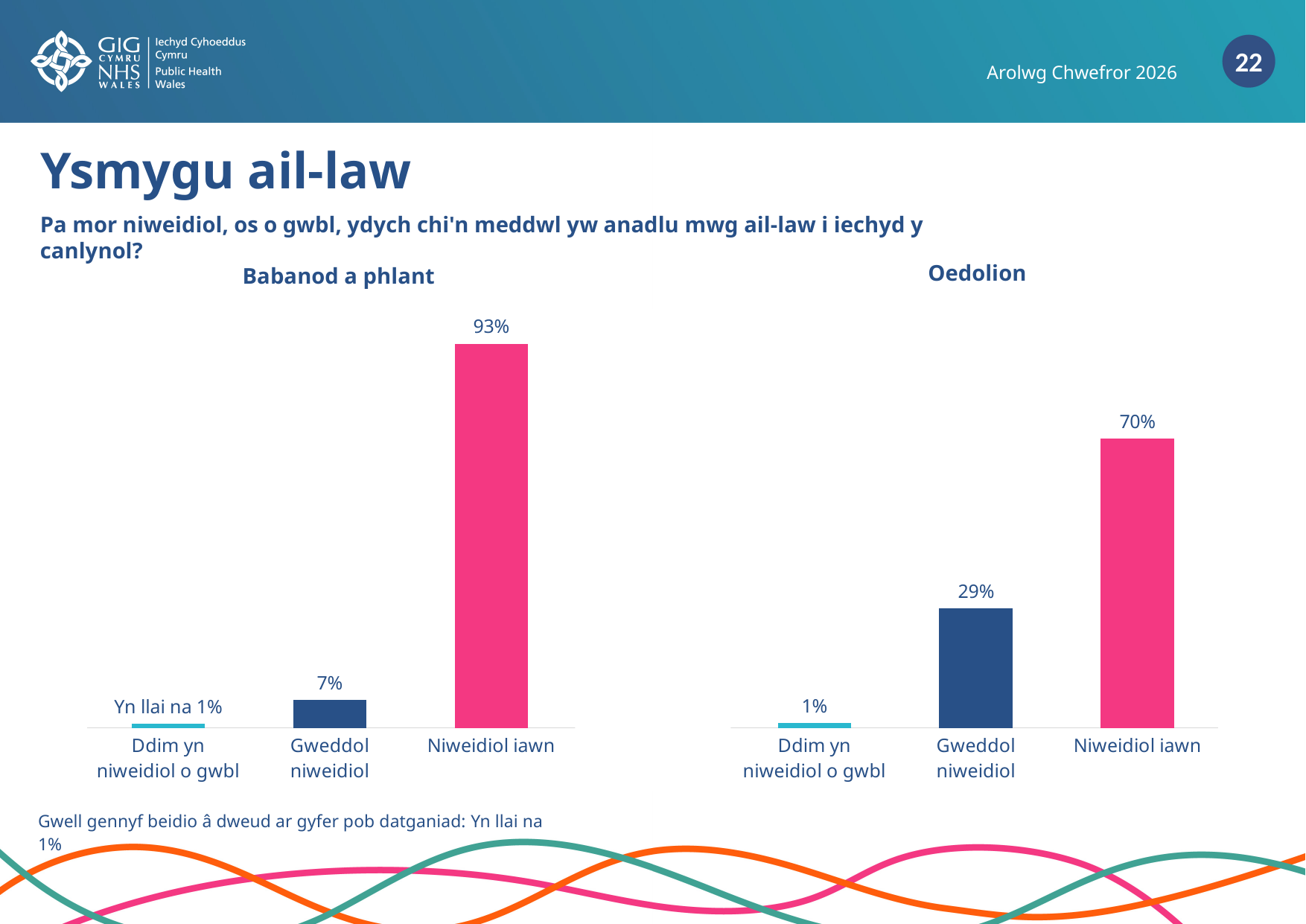
In the 'Babanod a phlant' chart, what label is shown for 'Ddim yn niweidiol o gwbl'? Yn llai na 1% What type of chart is the 'Babanod a phlant' chart? Bar chart In the 'Oedolion' chart, what is the difference between 'Niweidiol iawn' and 'Gweddol niweidiol'? 41% In the 'Oedolion' chart, what is the value for 'Ddim yn niweidiol o gwbl'? 1% In the 'Babanod a phlant' chart, what is the value for 'Gweddol niweidiol'? 7% How many categories are shown in the 'Oedolion' chart? 3 In the 'Oedolion' chart, which category has the highest value? Niweidiol iawn In the 'Babanod a phlant' chart, which category has the lowest value? Ddim yn niweidiol o gwbl In the 'Oedolion' chart, what is the value for 'Gweddol niweidiol'? 29% In the 'Babanod a phlant' chart, what is the value for 'Niweidiol iawn'? 93% Which is larger: 'Niweidiol iawn' in the 'Babanod a phlant' chart or 'Niweidiol iawn' in the 'Oedolion' chart? Babanod a phlant In the 'Oedolion' chart, what is the value for 'Niweidiol iawn'? 70%